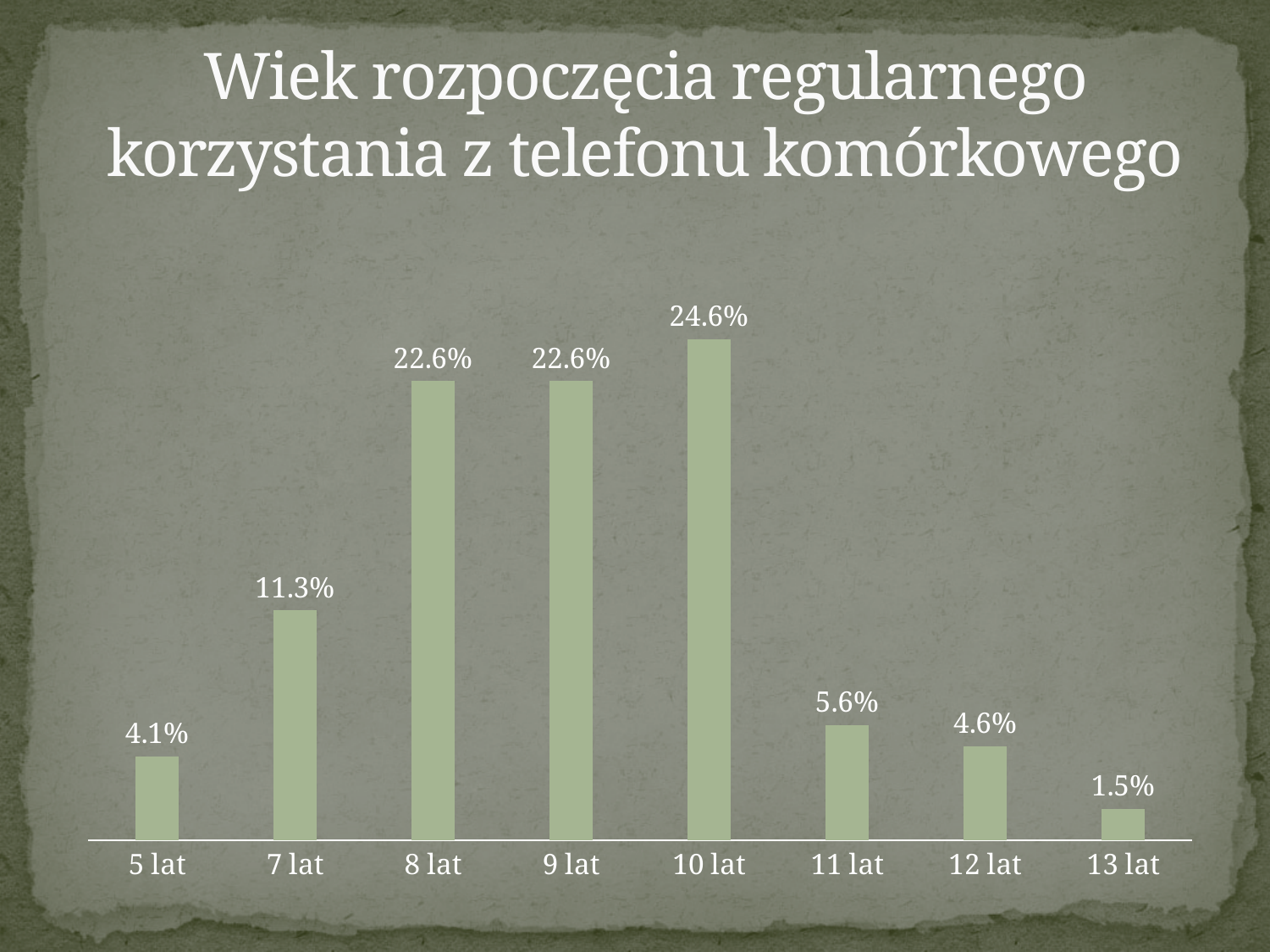
What is the difference between the values for 10 lat and 8 lat? 2.0% What kind of chart is shown on the slide? Bar chart What is the title of the chart? Wiek rozpoczęcia regularnego korzystania z telefonu komórkowego What is the value for 7 lat? 11.3% Which category has the lowest value? 13 lat What is the value for 13 lat? 1.5% How many categories are shown on the x axis? 8 What is the value for 10 lat? 24.6% What is the value for 5 lat? 4.1% Which is larger, the value for 7 lat or the value for 11 lat? 7 lat What is the difference between the values for 11 lat and 12 lat? 1.0% Which category has the highest value? 10 lat